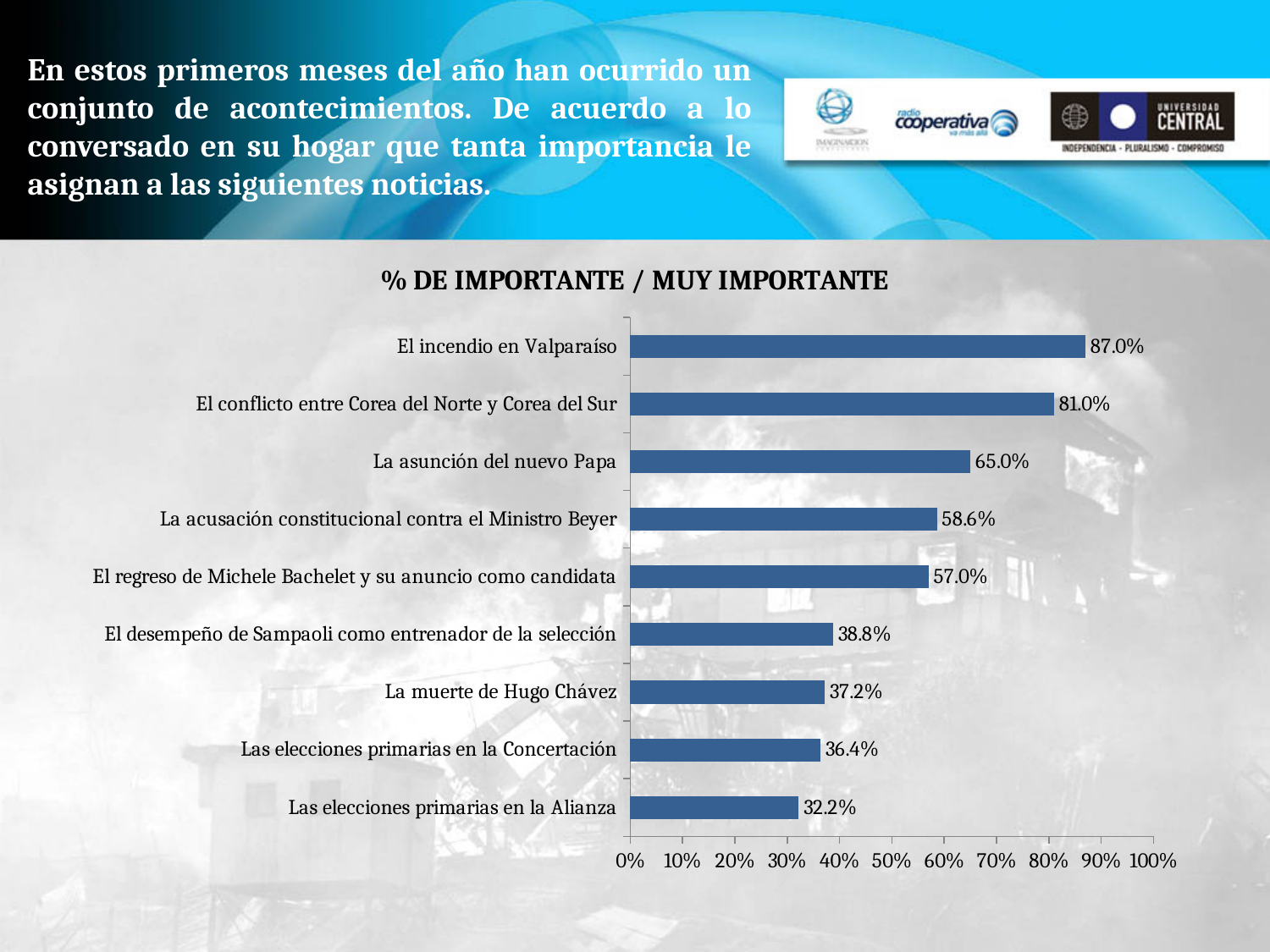
What kind of chart is shown on the slide? bar chart What is the value for "El incendio en Valparaíso"? 87.0% What is the title of the chart? % DE IMPORTANTE / MUY IMPORTANTE What is the value for "La muerte de Hugo Chávez"? 37.2% What is the difference between the values for "Las elecciones primarias en la Concertación" and "Las elecciones primarias en la Alianza"? 4.2% Which category has the highest value? El incendio en Valparaíso What is the value for "La asunción del nuevo Papa"? 65.0% Which category has the lowest value? Las elecciones primarias en la Alianza What is the difference between the values for "El incendio en Valparaíso" and "El conflicto entre Corea del Norte y Corea del Sur"? 6.0% Is the value for "El desempeño de Sampaoli como entrenador de la selección" greater or less than 50%? less Which is larger: the value for "La acusación constitucional contra el Ministro Beyer" or the value for "El regreso de Michele Bachelet y su anuncio como candidata"? La acusación constitucional contra el Ministro Beyer How many categories are shown in the chart? 9